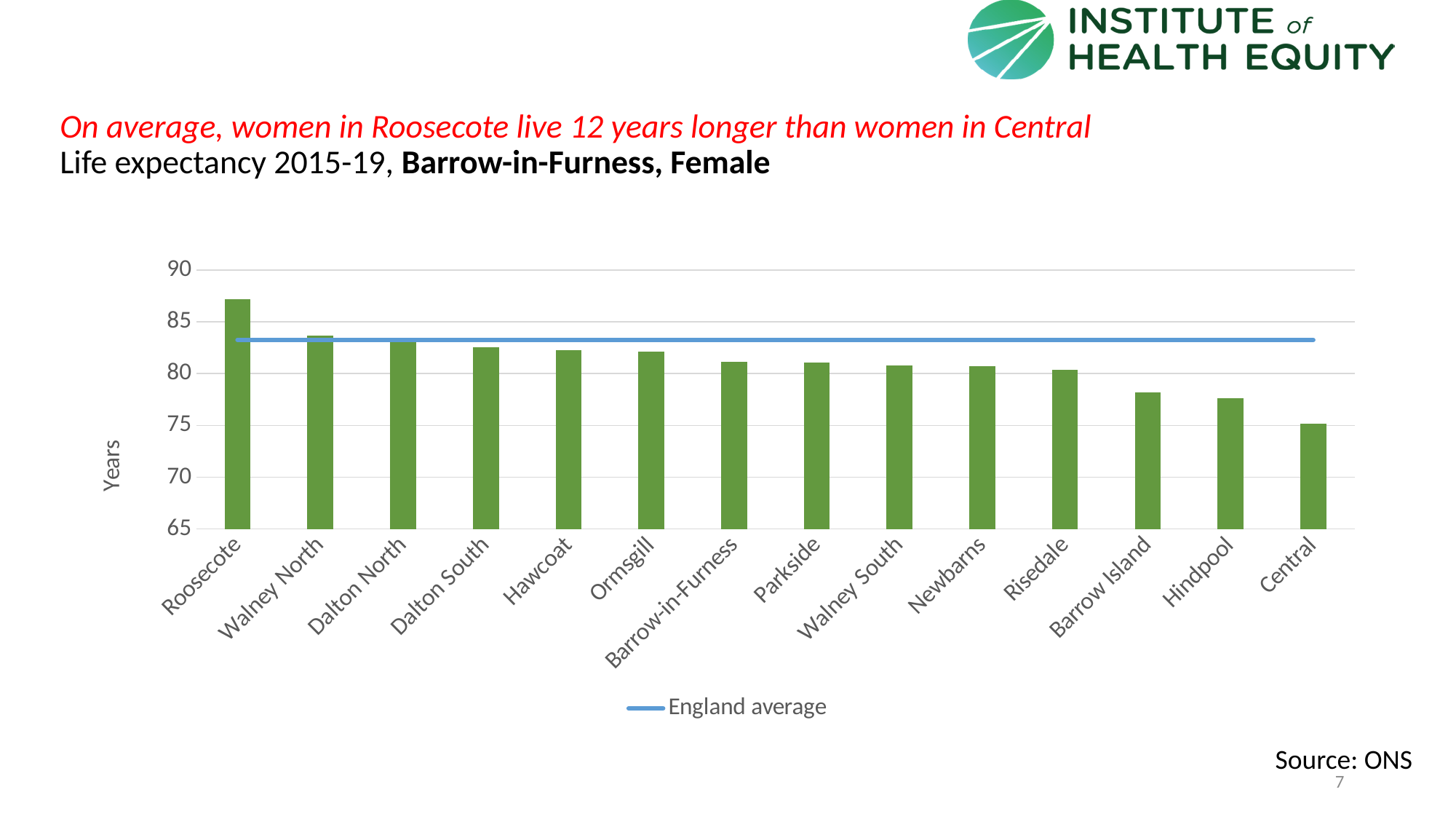
What is the label on the y axis of the chart? Years Which has the higher female life expectancy, Walney North or Hindpool? Walney North What entry does the chart's legend list? England average Is the value for Roosecote greater or less than 85? greater What kind of chart is shown on the slide? bar chart Is the value for Central greater or less than 80? less Which area has the lowest female life expectancy in the chart? Central Is the value for Barrow Island greater or less than 80? less Which area has the highest female life expectancy in the chart? Roosecote How many areas (categories) are plotted on the x axis of the chart? 14 Do the bar values rise or fall moving from left to right along the x axis? fall